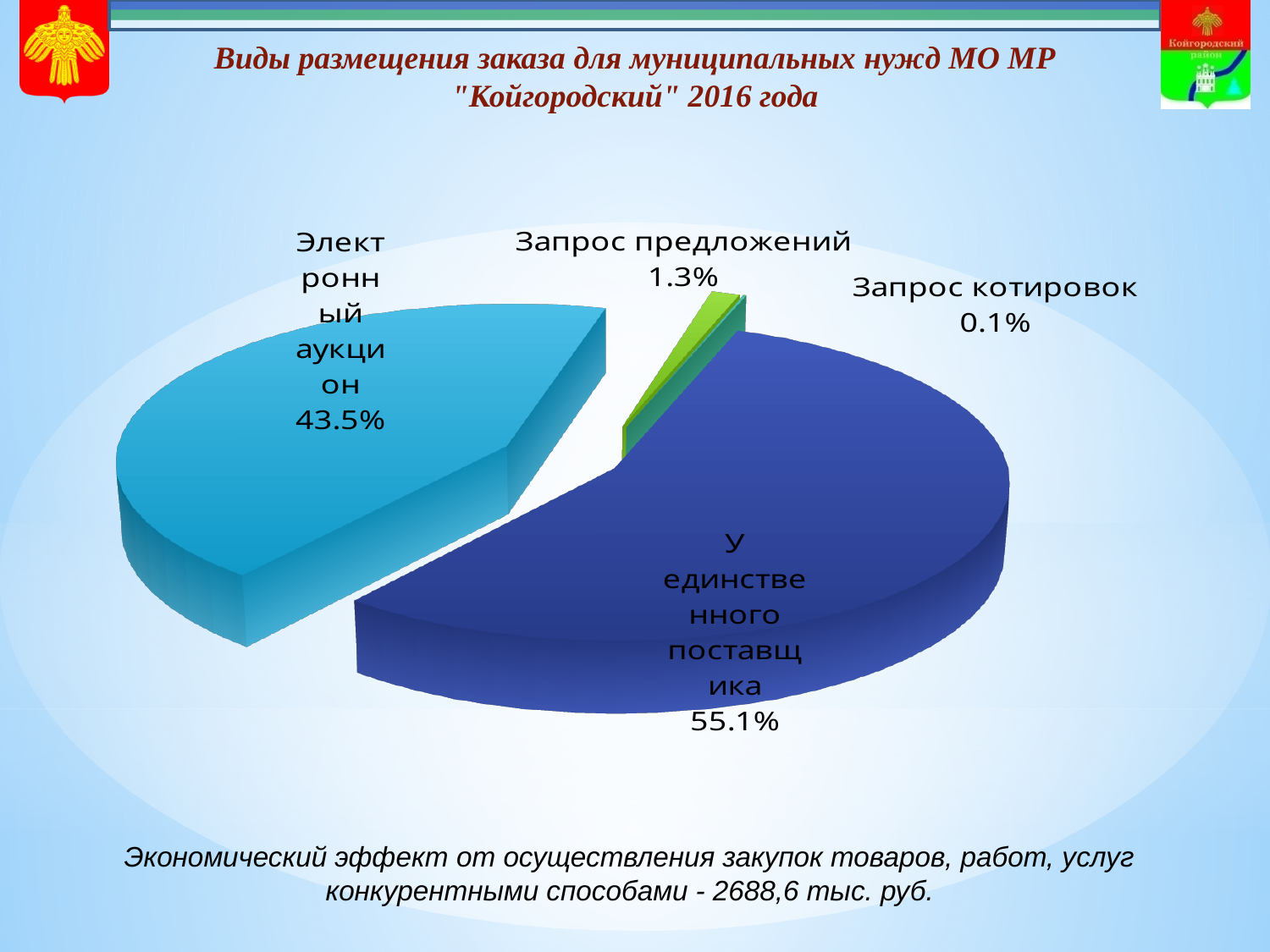
How many categories are shown in the pie chart? 4 What kind of chart is shown on the slide? Pie chart What colour is the slice for "Электронный аукцион"? Light blue What is the combined share of "Запрос предложений" and "Запрос котировок"? 1.4% What is the difference in percentage points between "У единственного поставщика" and "Электронный аукцион"? 11.6 What share of the pie does "Запрос котировок" have? 0.1% What share of the pie does "У единственного поставщика" have? 55.1% Which category has the largest share of the pie? У единственного поставщика What share of the pie does "Электронный аукцион" have? 43.5% What share of the pie does "Запрос предложений" have? 1.3% Which is larger: the share for "Запрос предложений" or the share for "Запрос котировок"? Запрос предложений Which category has the smallest share of the pie? Запрос котировок